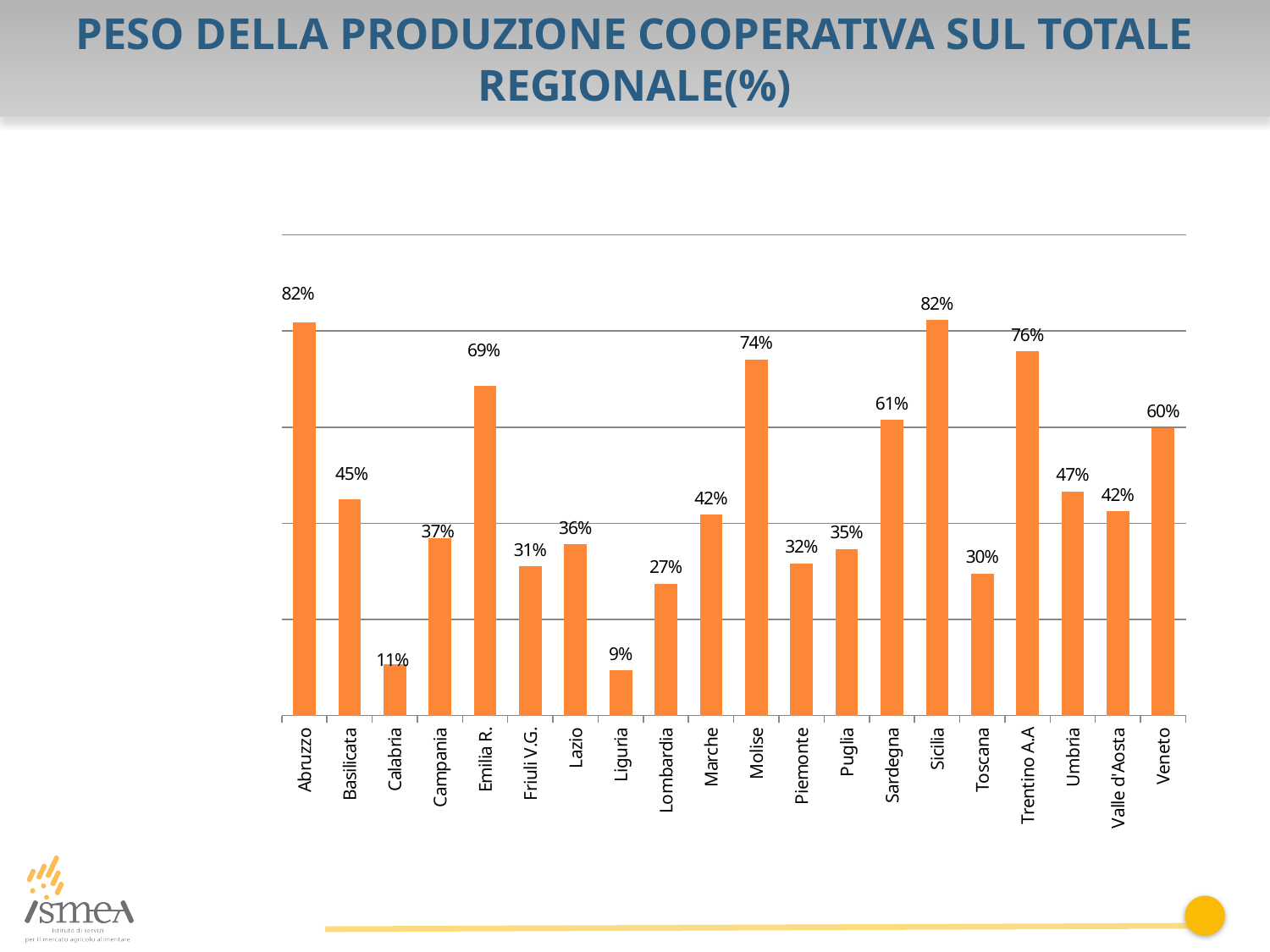
What is the value for Toscana? 30% Which region has the lowest value? Liguria Which is larger, the value for Basilicata or the value for Umbria? Umbria What is the value for Molise? 74% Which regions share the highest value of 82%? Abruzzo and Sicilia What is the value for Emilia R.? 69% How many regions are shown on the x axis? 20 What kind of chart is shown on the slide? Bar chart What is the value for Trentino A.A? 76% What is the difference between the values for Abruzzo and Liguria? 73% What is the difference between the values for Sardegna and Veneto? 1% What is the value for Calabria? 11%